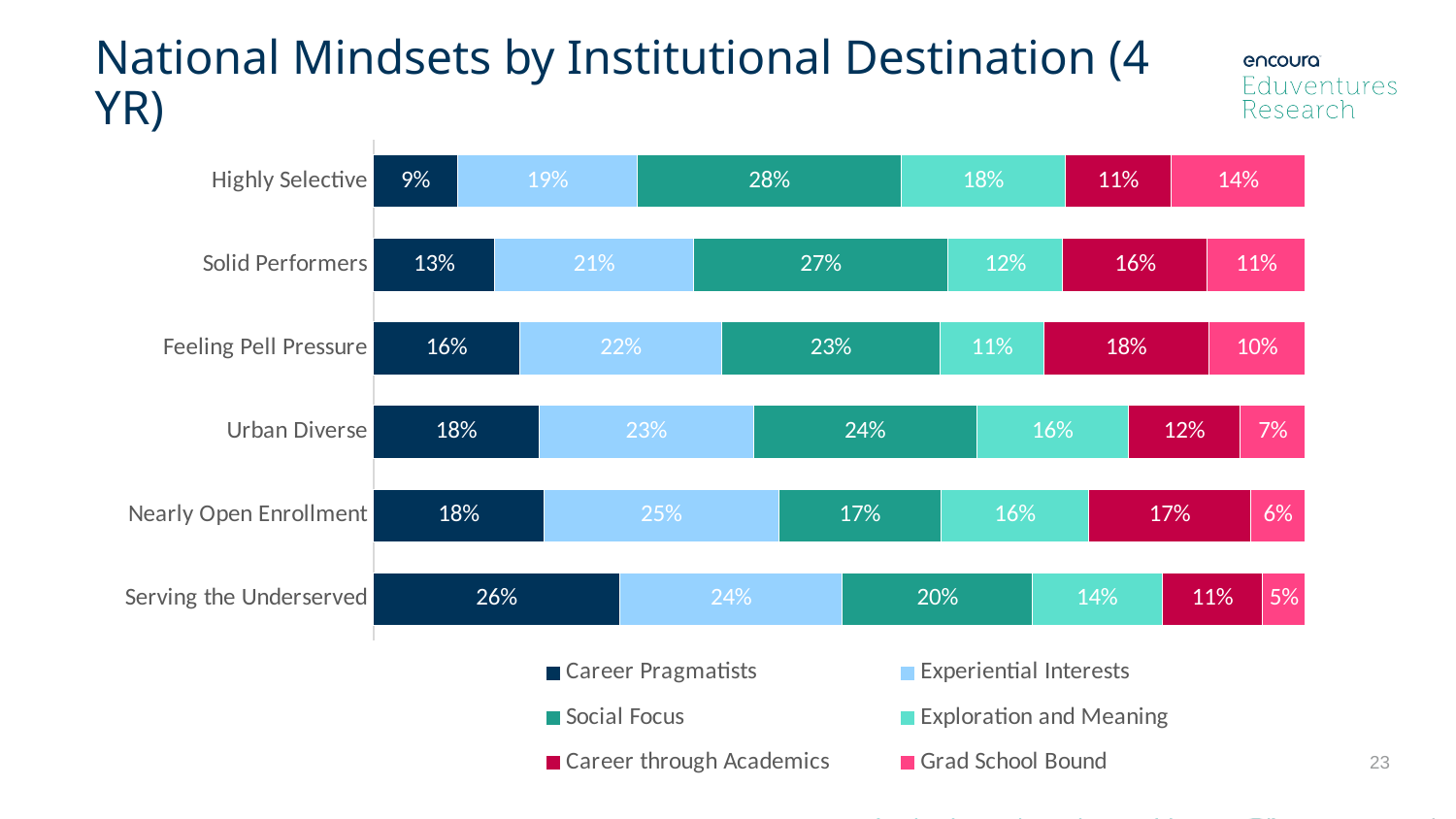
What is the difference between the Career through Academics values for Feeling Pell Pressure and Urban Diverse? 6 percentage points Which institutional destination has the highest Grad School Bound share? Highly Selective Which institutional destination has the lowest Career Pragmatists share? Highly Selective What is the Social Focus value for Highly Selective? 28% What is the title of the chart? National Mindsets by Institutional Destination (4 YR) What is the total of the segments in the Urban Diverse bar? 100% What type of chart is shown on the slide? Stacked bar chart Which has a larger Experiential Interests value: Nearly Open Enrollment or Solid Performers? Nearly Open Enrollment How many series does the legend list? 6 How many institutional destination categories are shown in the chart? 6 What is the Career Pragmatists value for Serving the Underserved? 26% What is the Exploration and Meaning value for Feeling Pell Pressure? 11%